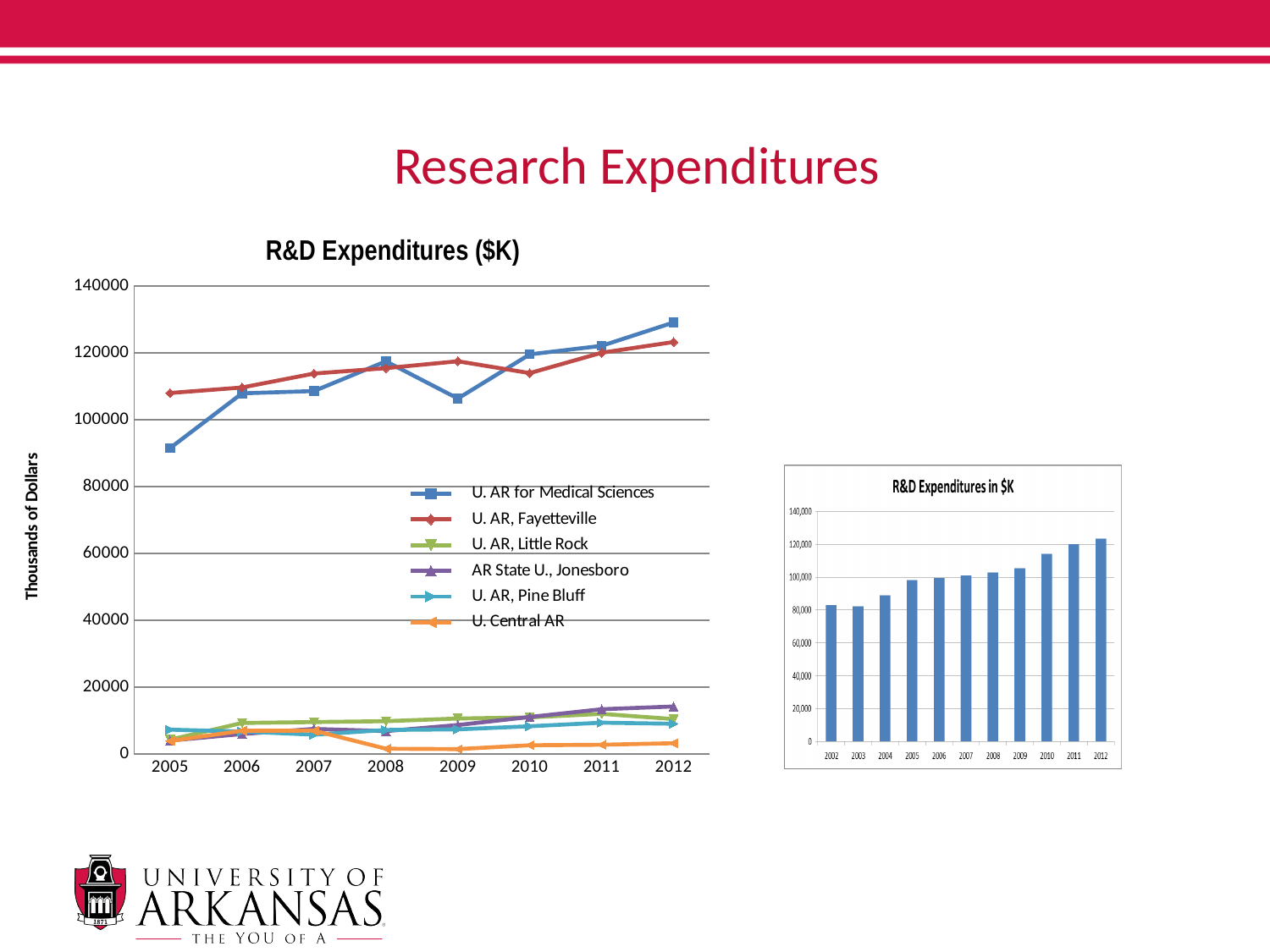
In the 'R&D Expenditures in $K' bar chart on the right, do the values generally rise or fall from 2002 to 2012? rise What kind of chart is the 'R&D Expenditures in $K' chart on the right? bar chart How many bars are in the 'R&D Expenditures in $K' chart on the right? 11 How many series does the legend of the 'R&D Expenditures ($K)' chart list? 6 In the 'R&D Expenditures ($K)' chart, which series has the highest value in 2012? U. AR for Medical Sciences How many years are shown on the x axis of the 'R&D Expenditures ($K)' chart? 8 In the 'R&D Expenditures ($K)' chart, which series has the lowest value in 2012? U. Central AR In the 'R&D Expenditures ($K)' chart, is the value for U. AR, Fayetteville in 2005 greater or less than 100000? greater What kind of chart is the 'R&D Expenditures ($K)' chart on the left? line chart In the 'R&D Expenditures ($K)' chart, is the value for U. AR for Medical Sciences in 2005 greater or less than 100000? less In the 'R&D Expenditures ($K)' chart, is the value for U. AR for Medical Sciences in 2012 greater or less than 120000? greater In the 'R&D Expenditures ($K)' chart, which is larger in 2009: U. AR, Fayetteville or U. AR for Medical Sciences? U. AR, Fayetteville